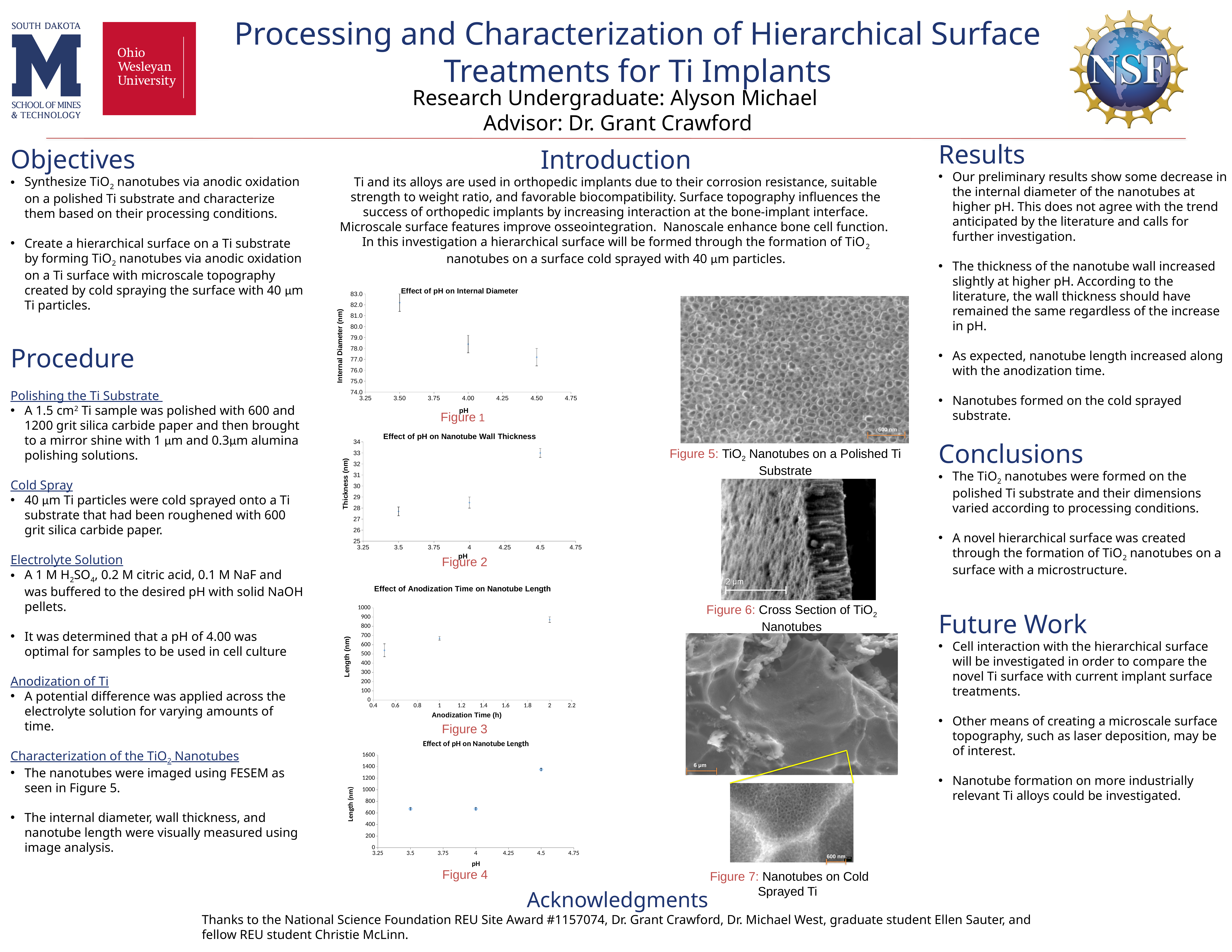
In Figure 4, "Effect of pH on Nanotube Length", at which pH is the nanotube length highest? 4.5 In Figure 1, "Effect of pH on Internal Diameter", is the internal diameter at pH 3.50 greater or less than 80.0 nm? greater What is the x-axis label of Figure 3, "Effect of Anodization Time on Nanotube Length"? Anodization Time (h) In Figure 3, "Effect of Anodization Time on Nanotube Length", is the length at 2 h greater or less than 800 nm? greater In Figure 2, "Effect of pH on Nanotube Wall Thickness", at which pH is the wall thickness highest? 4.5 In Figure 1, "Effect of pH on Internal Diameter", does the internal diameter rise or fall as pH increases? fall In Figure 1, "Effect of pH on Internal Diameter", at which pH is the internal diameter highest? 3.50 In Figure 2, "Effect of pH on Nanotube Wall Thickness", is the thickness at pH 4.5 greater or less than 30 nm? greater What kind of chart is Figure 1, "Effect of pH on Internal Diameter"? Scatter chart In Figure 1, "Effect of pH on Internal Diameter", how many data points are plotted? 3 In Figure 3, "Effect of Anodization Time on Nanotube Length", does nanotube length rise or fall as anodization time increases? rise